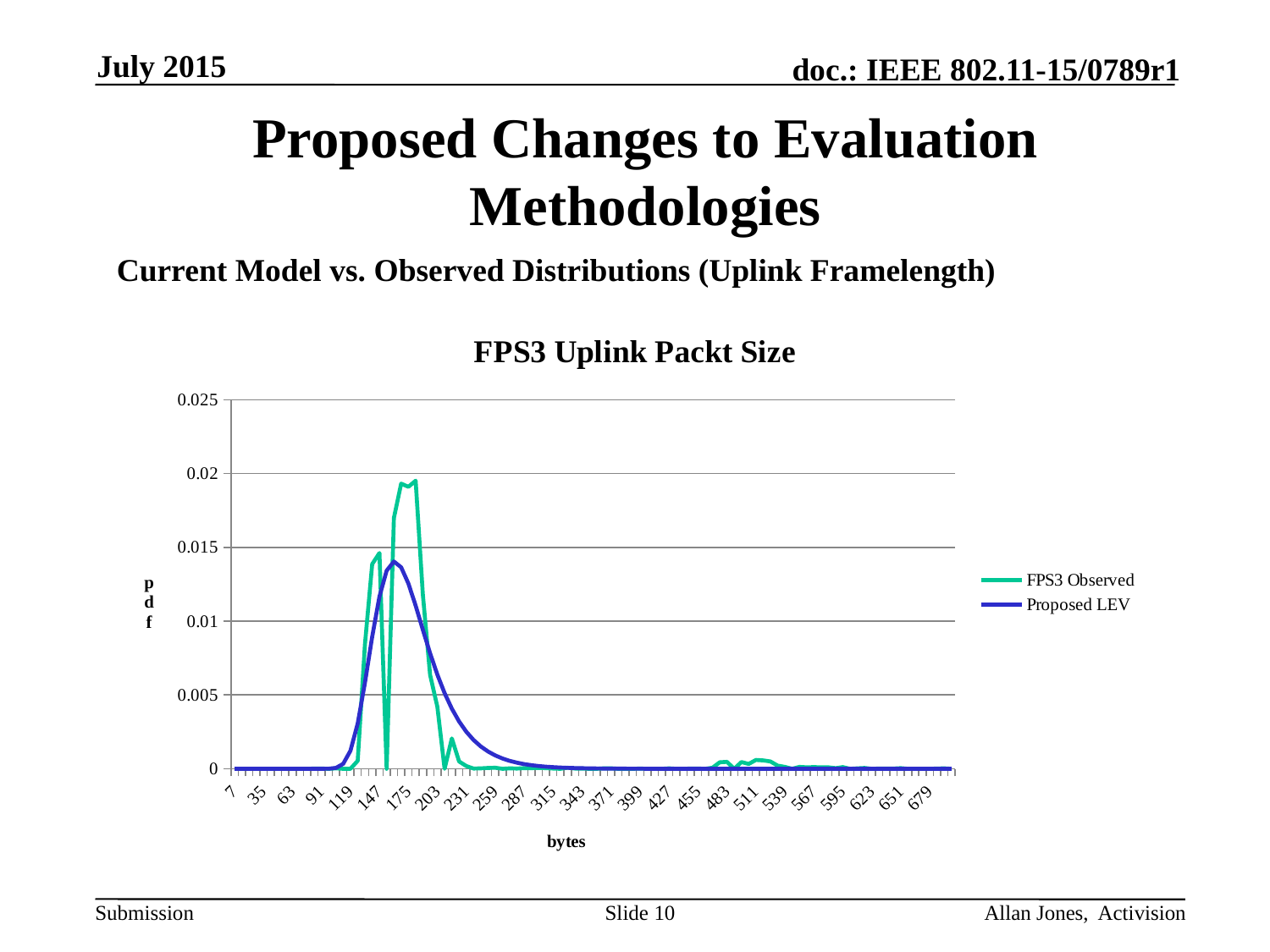
Does the Proposed LEV curve rise or fall between 175 bytes and 259 bytes? fall Is the peak value of the Proposed LEV series greater or less than 0.01? greater Is the value of the Proposed LEV series at 399 bytes greater or less than 0.005? less What is the highest value shown on the y axis? 0.025 What is the title of the chart? FPS3 Uplink Packt Size How many series does the legend list? 2 Which series reaches the higher peak value, FPS3 Observed or Proposed LEV? FPS3 Observed What label is shown on the x axis of the chart? bytes Is the value of the FPS3 Observed series at 7 bytes greater or less than 0.005? less What kind of chart is shown on the slide? line chart